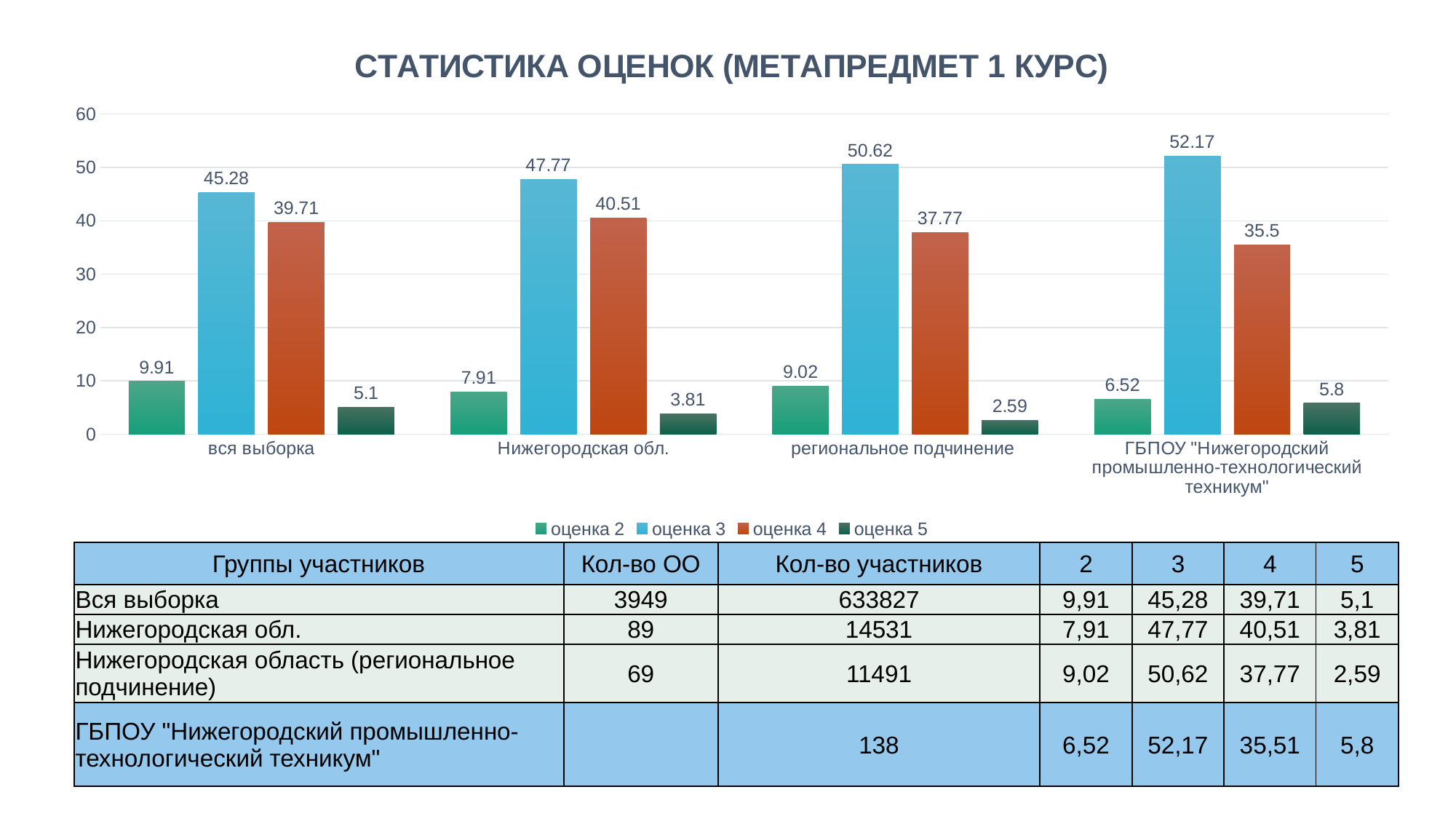
What kind of chart is shown on the slide? bar chart What is the value of оценка 4 for ГБПОУ "Нижегородский промышленно-технологический техникум"? 35.5 How many series does the chart legend list? 4 Which is larger: оценка 2 for вся выборка or оценка 2 for Нижегородская обл.? вся выборка What is the title of the chart? СТАТИСТИКА ОЦЕНОК (МЕТАПРЕДМЕТ 1 КУРС) What is the difference between оценка 3 and оценка 4 for Нижегородская обл.? 7.26 What is the value of оценка 3 for вся выборка? 45.28 What is the value of оценка 5 for Нижегородская обл.? 3.81 How many categories are shown on the x axis of the chart? 4 Which category has the highest value for оценка 3? ГБПОУ "Нижегородский промышленно-технологический техникум" What is the value of оценка 2 for региональное подчинение? 9.02 Which category has the lowest value for оценка 5? региональное подчинение